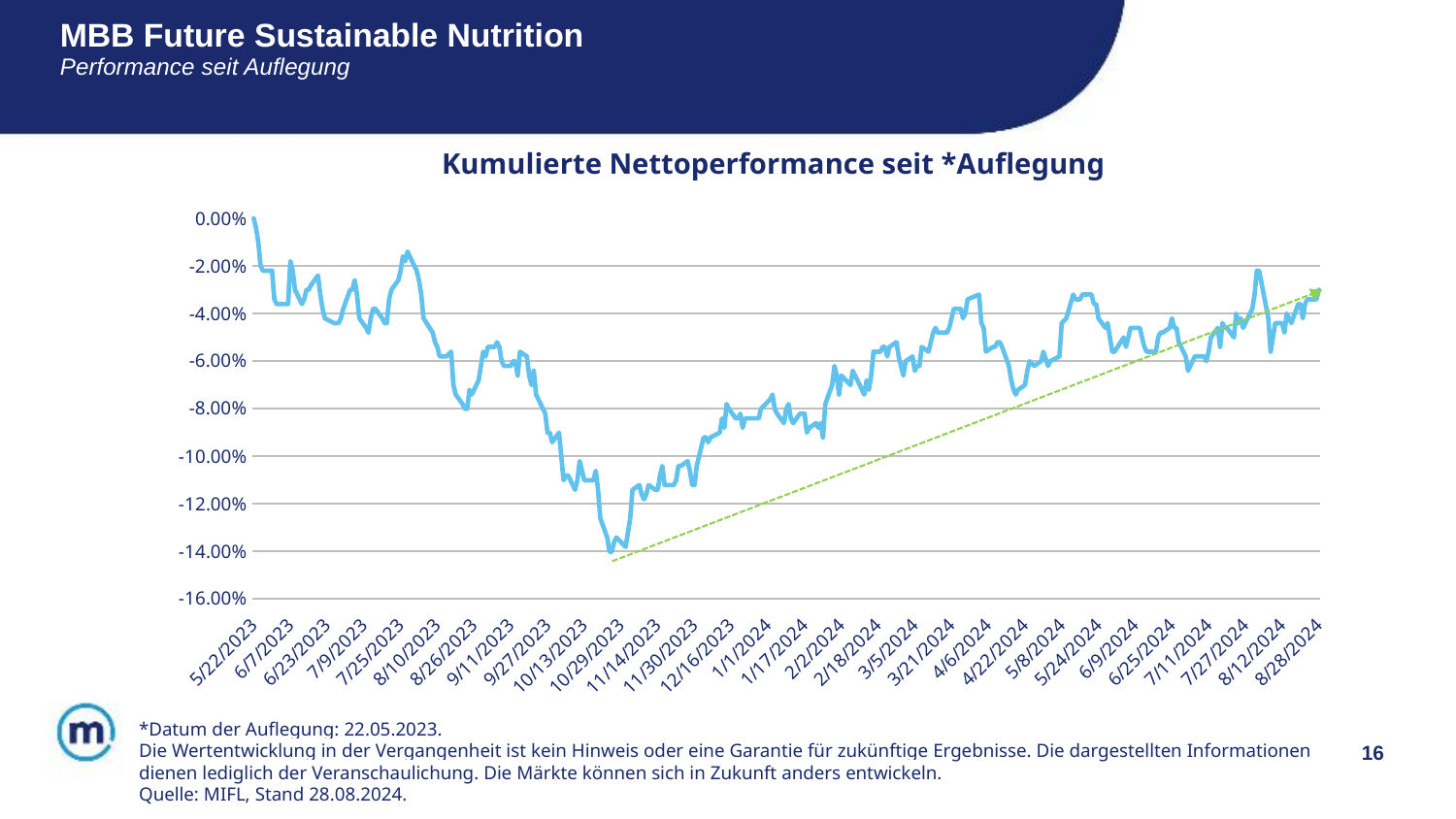
Is the value around 10/29/2023 greater or less than -10.00%? less What is the lowest value shown on the vertical axis? -16.00% Is the value at the last date, 8/28/2024, greater or less than -6.00%? greater Does the line rise or fall between 5/22/2023 and 10/29/2023? fall What is the title of the chart? Kumulierte Nettoperformance seit *Auflegung Is the lowest point of the line greater or less than -12.00%? less What is the value of the line at the first date, 5/22/2023? 0.00% In which month does the line reach its lowest point? October 2023 Does the line rise or fall from its low point in late October 2023 to the end of the chart in August 2024? rise Which date has the higher value: 5/22/2023 or 8/28/2024? 5/22/2023 What kind of chart is shown on the slide? line chart